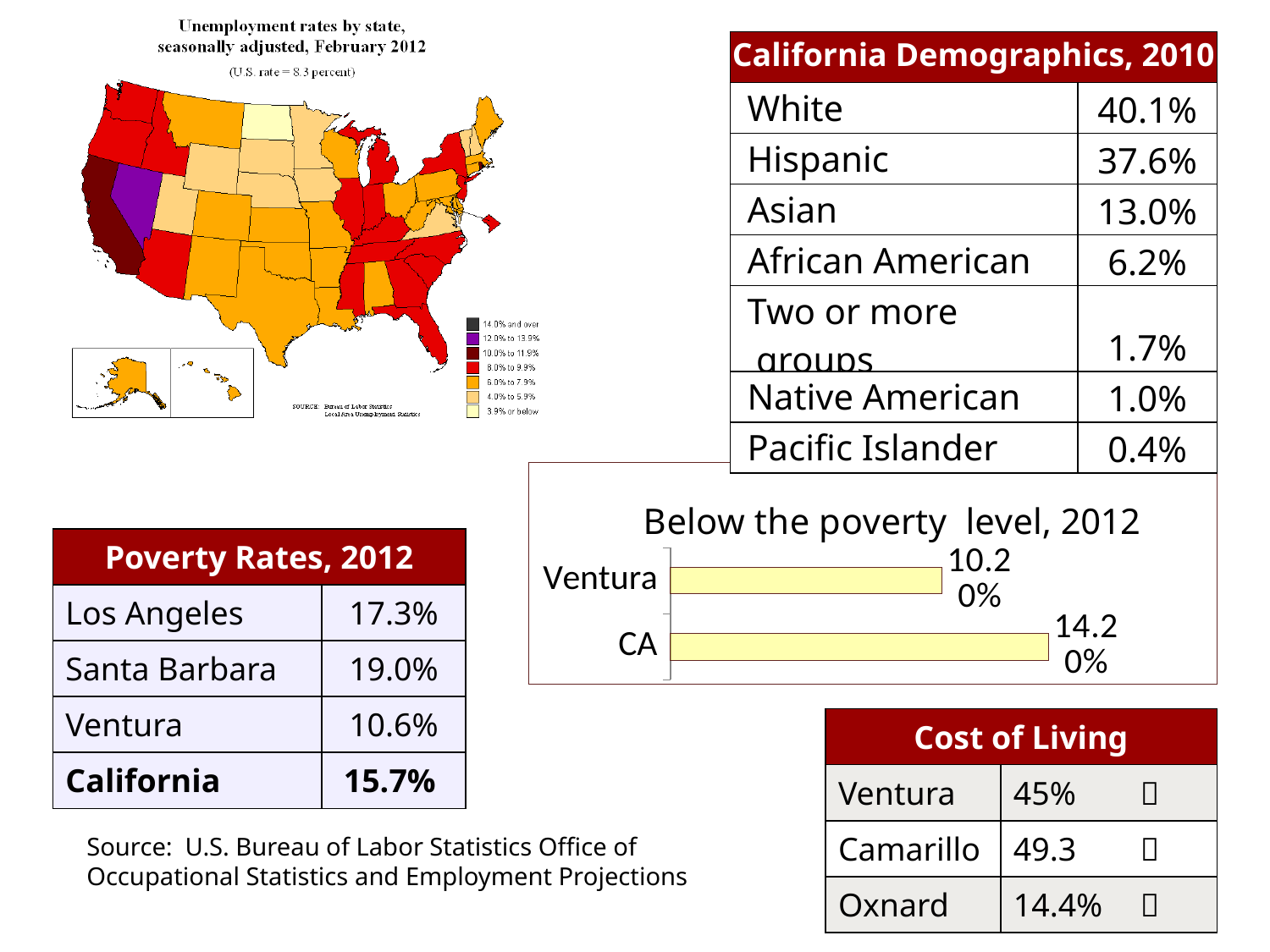
What is the title of the bar chart on the slide? Below the poverty level, 2012 In the 'Below the poverty level, 2012' chart, what is the value for CA? 14.20% In the 'Below the poverty level, 2012' chart, which category has the lowest value? Ventura In the 'Below the poverty level, 2012' chart, what is the value for Ventura? 10.20% What colour are the bars in the 'Below the poverty level, 2012' chart? light yellow How many categories are plotted in the 'Below the poverty level, 2012' chart? 2 In the 'Below the poverty level, 2012' chart, which category has the highest value? CA In the 'Below the poverty level, 2012' chart, what is the difference between the CA value and the Ventura value? 4.00% In the 'Below the poverty level, 2012' chart, which is larger, the value for Ventura or the value for CA? CA What kind of chart is the 'Below the poverty level, 2012' chart? bar chart